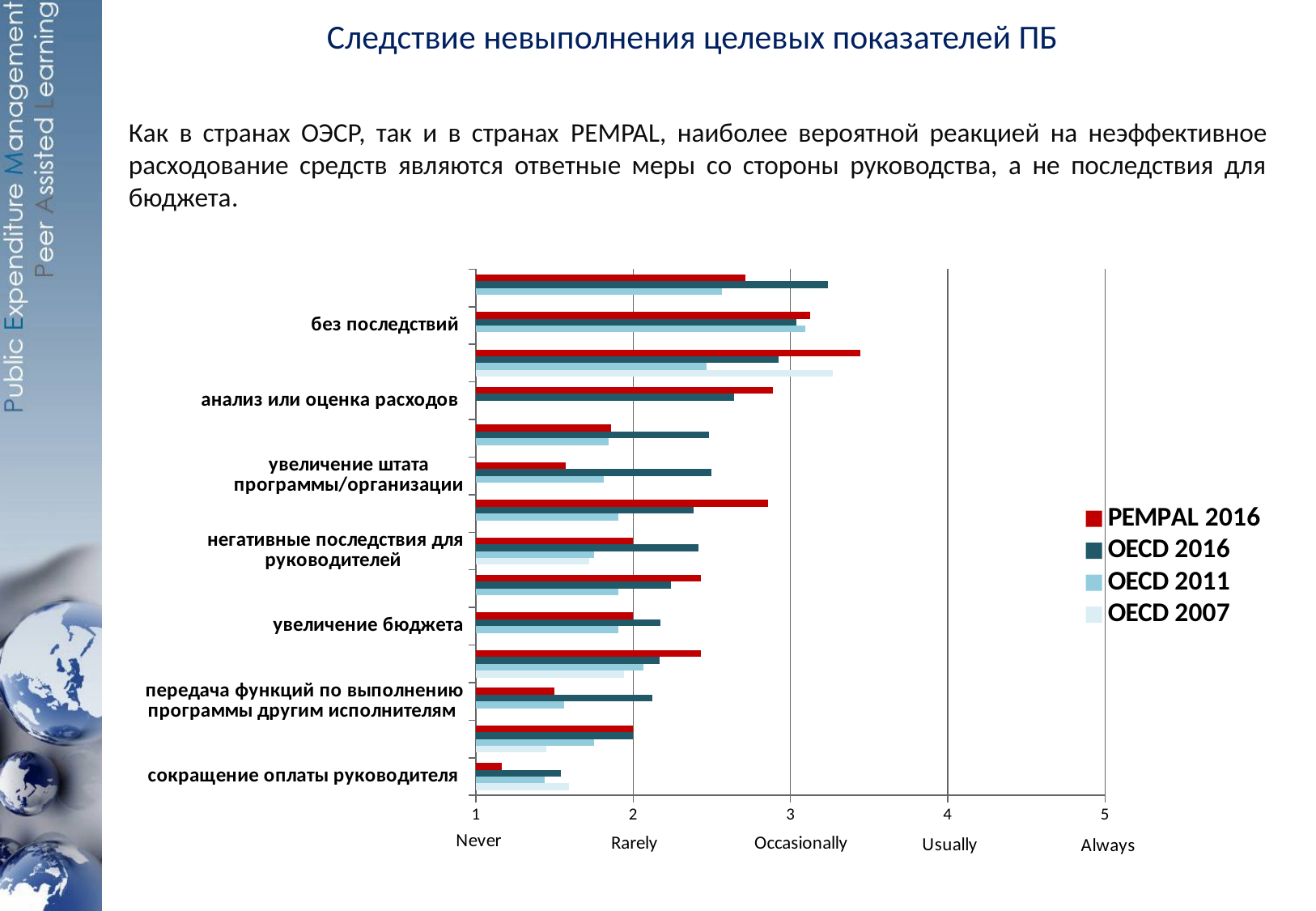
How many series does the chart legend list? 4 What kind of chart is shown on the slide? bar chart Does any bar on the chart reach the value 4? No What word labels the value 1 on the horizontal axis? Never Is the longest bar on the chart greater or less than 3? greater Which series is shown in red on the chart? PEMPAL 2016 What word labels the value 5 on the horizontal axis? Always